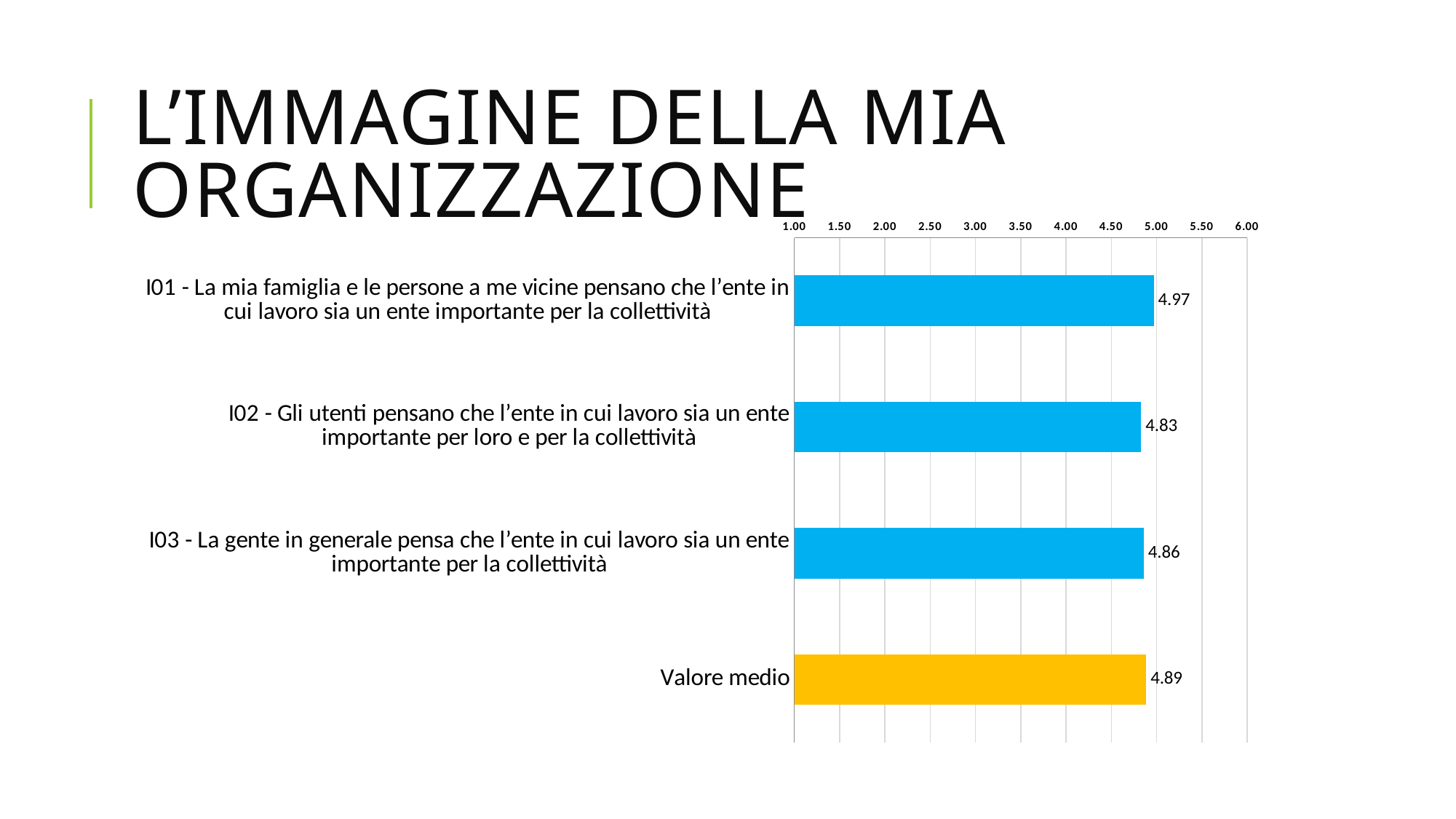
What is the value for I03 - La gente in generale pensa che l'ente in cui lavoro sia un ente importante per la collettività? 4.86 Which of the three items I01, I02 and I03 has the lowest value? I02 How many bars are plotted in the chart? 4 What kind of chart is shown on the slide? Bar chart What is the difference between the value for I01 and the value for I02? 0.14 Which is larger, the value for I01 or the Valore medio? I01 What is the difference between the Valore medio and the value for I03? 0.03 What is the value for I01 - La mia famiglia e le persone a me vicine pensano che l'ente in cui lavoro sia un ente importante per la collettività? 4.97 Which of the three items I01, I02 and I03 has the highest value? I01 What is the value for I02 - Gli utenti pensano che l'ente in cui lavoro sia un ente importante per loro e per la collettività? 4.83 What is the value shown for Valore medio? 4.89 What colour is the bar for Valore medio? Yellow